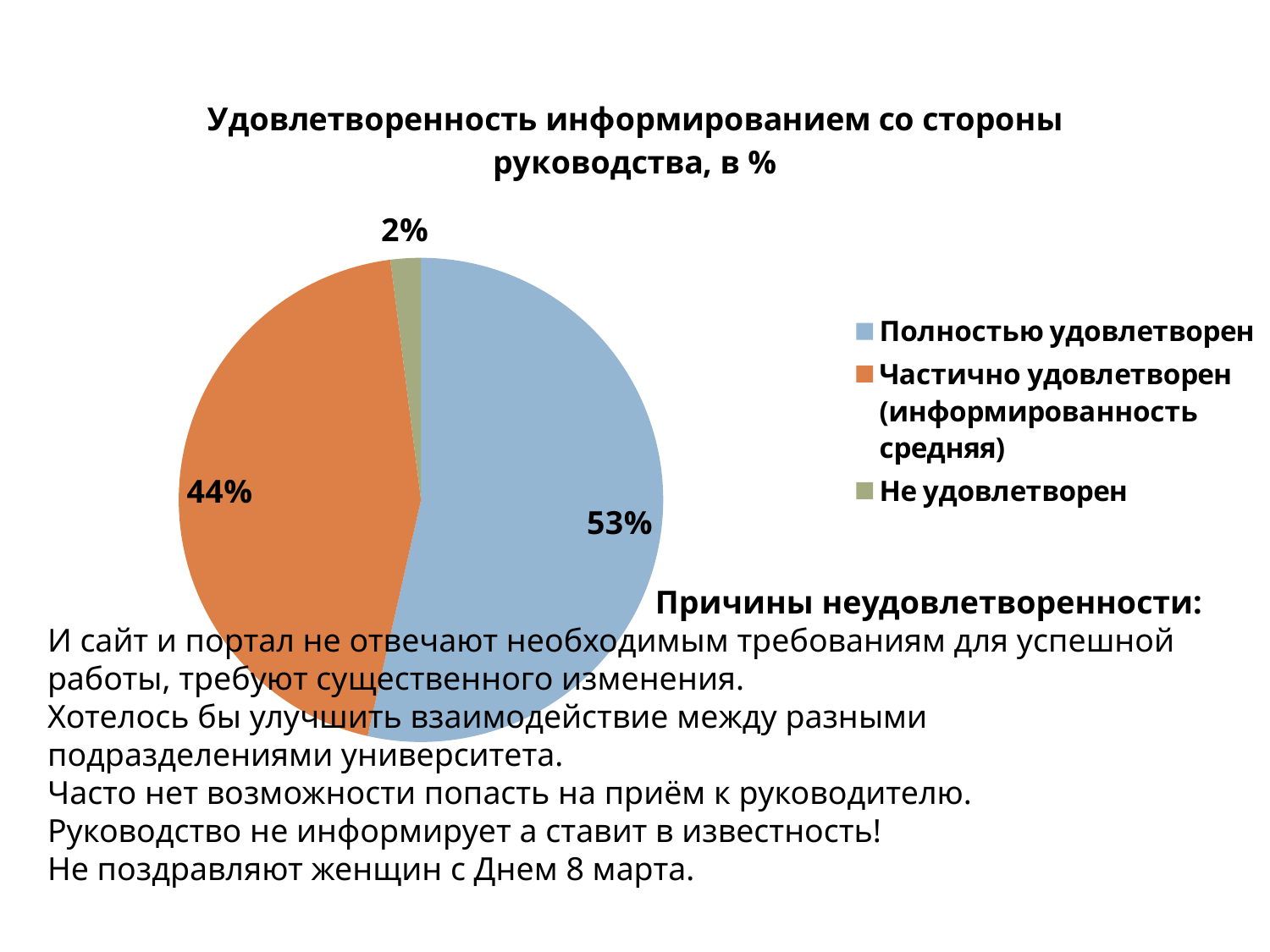
Which category has the largest slice of the pie? Полностью удовлетворен What share of the pie is labelled "Не удовлетворен"? 2% Which is larger: the "Частично удовлетворен (информированность средняя)" share or the "Не удовлетворен" share? Частично удовлетворен (информированность средняя) What is the difference between the "Частично удовлетворен (информированность средняя)" and "Не удовлетворен" shares? 42% What colour is the slice for "Не удовлетворен"? grey-green What share of the pie is labelled "Частично удовлетворен (информированность средняя)"? 44% What is the title of the chart? Удовлетворенность информированием со стороны руководства, в % What share of the pie is labelled "Полностью удовлетворен"? 53% Which category has the smallest slice of the pie? Не удовлетворен How many categories does the legend list? 3 What is the difference between the "Полностью удовлетворен" and "Частично удовлетворен (информированность средняя)" shares? 9% What kind of chart is shown on the slide? pie chart